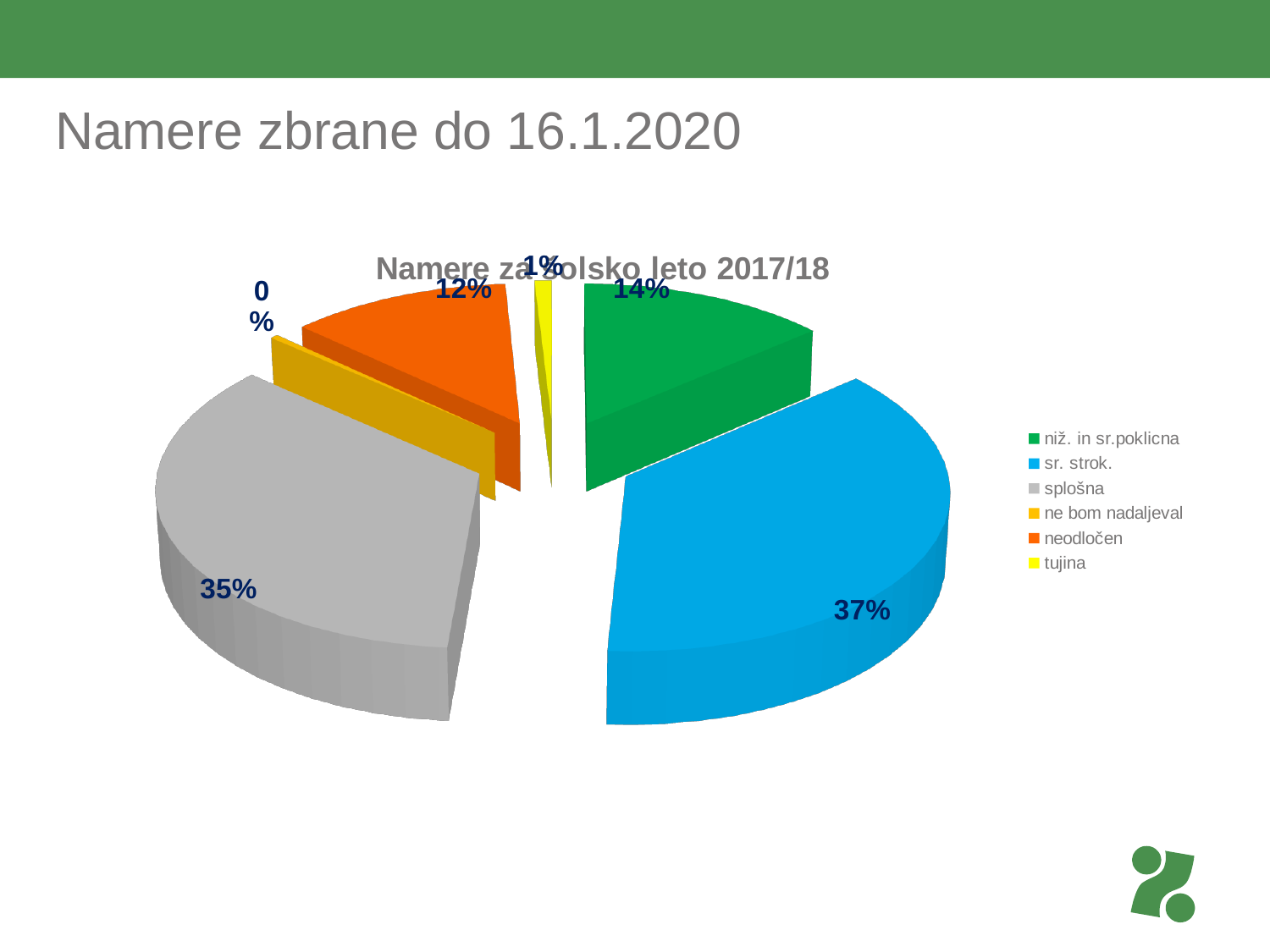
What share of the pie does "niž. in sr.poklicna" have? 14% What share of the pie does "sr. strok." have? 37% What is the difference in percentage points between "sr. strok." and "splošna"? 2% How many categories does the legend of the pie chart list? 6 What is the difference in percentage points between "splošna" and "neodločen"? 23% What is the title of the pie chart? Namere za šolsko leto 2017/18 What share of the pie does "tujina" have? 1% What share of the pie does "splošna" have? 35% Which category has the largest slice of the pie? sr. strok. What share of the pie does "neodločen" have? 12% What kind of chart is shown on the slide? pie chart Which is larger, the slice for "niž. in sr.poklicna" or the slice for "neodločen"? niž. in sr.poklicna